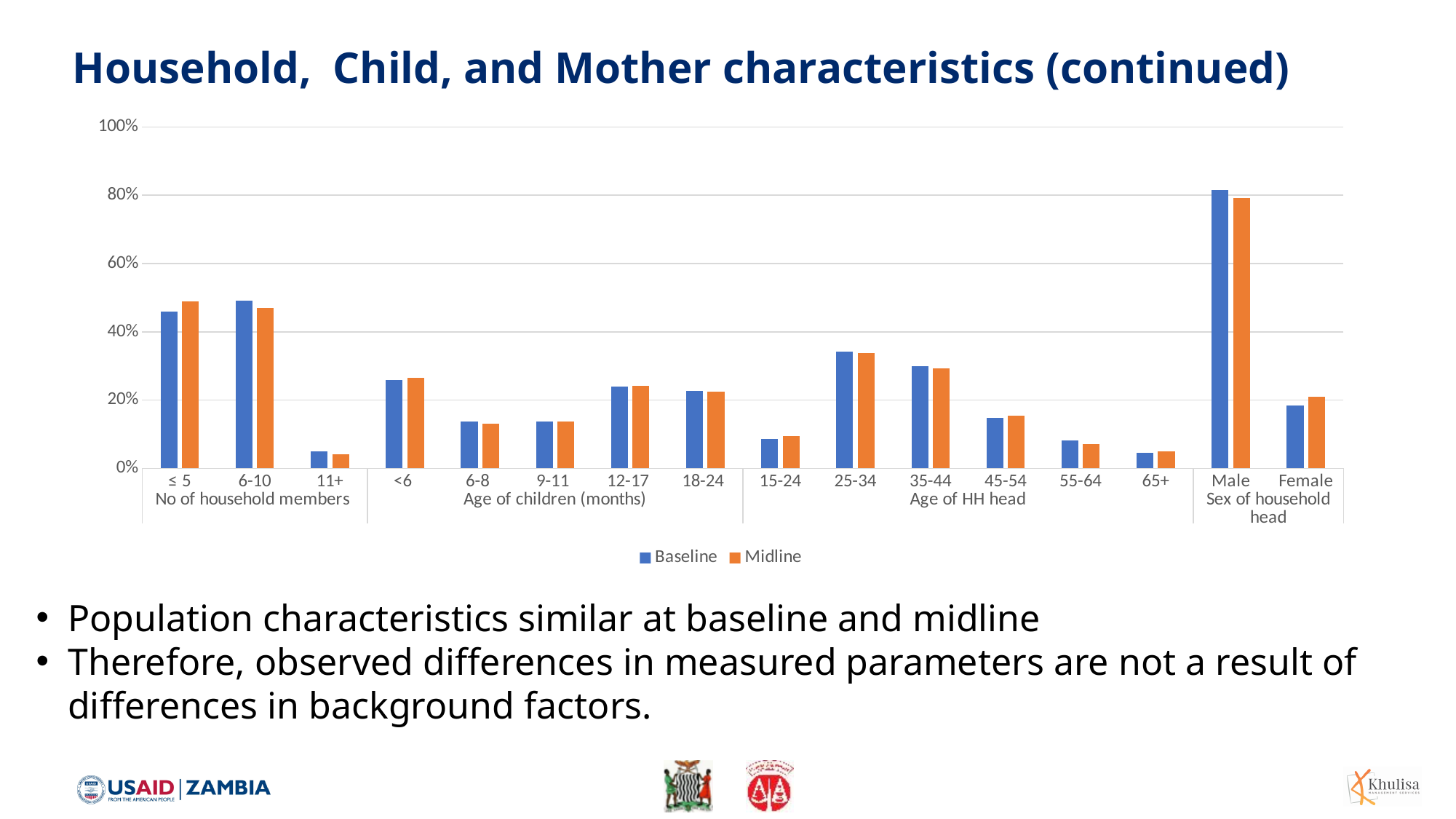
What kind of chart is shown on the slide? bar chart Which category has the highest Baseline value? Male Within the 'Age of HH head' group, which category has the lowest Midline value? 65+ Is the Baseline value for Female greater or less than 20%? less How many series does the legend list? 2 How many categories are shown along the x axis of the chart? 16 Is the Baseline value for ≤ 5 household members greater or less than 40%? greater Which colour represents the Midline series in the chart? orange Is the Midline value for 25-34 (Age of HH head) greater or less than 40%? less For the ≤ 5 household members category, which is larger, the Baseline or the Midline value? Midline Within the 'No of household members' group, which category has the lowest Baseline value? 11+ For the Baseline series, which is larger, the value for 25-34 or for 35-44 (Age of HH head)? 25-34